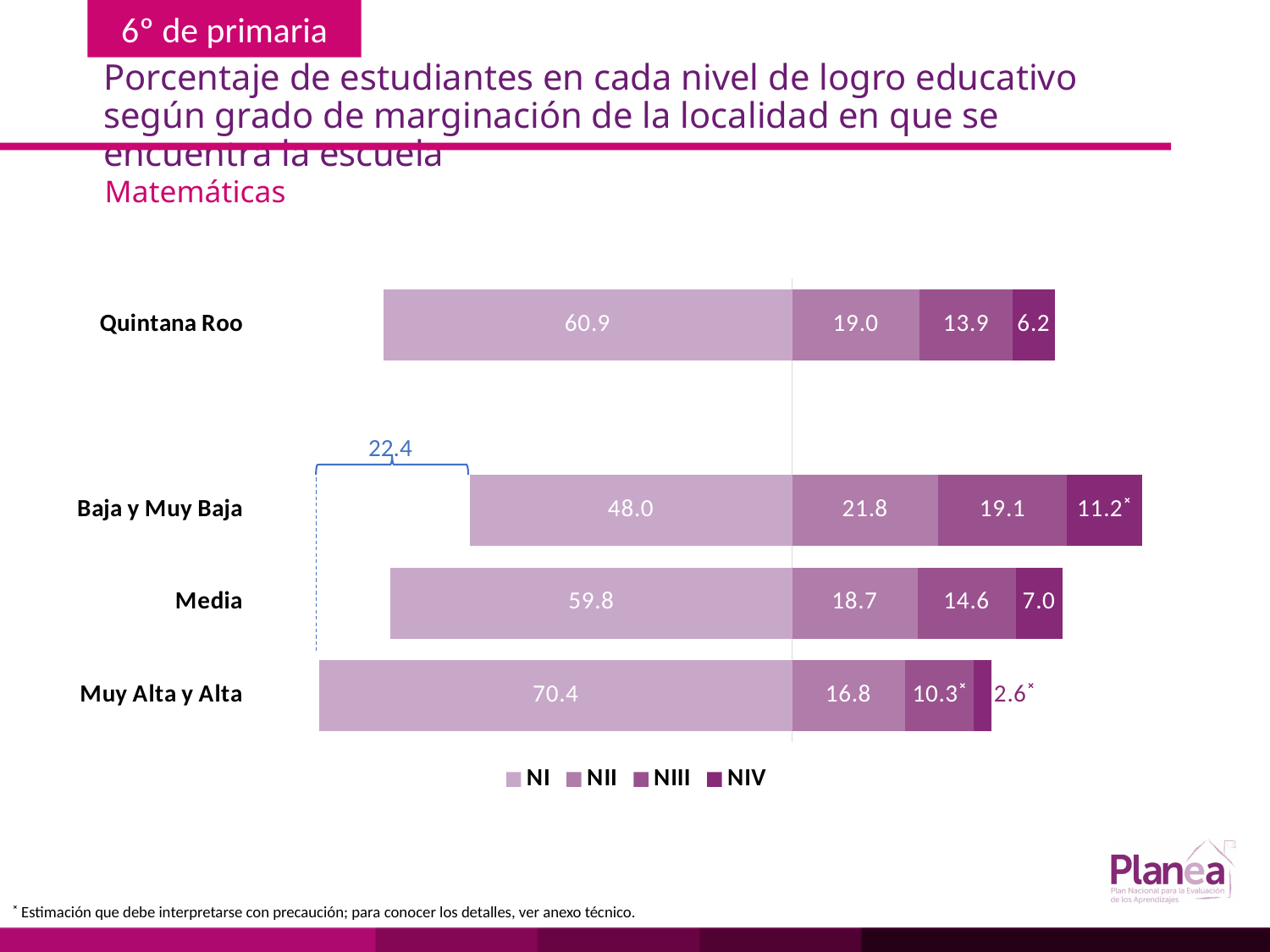
Which category has the lowest NIV value? Muy Alta y Alta What is the difference between the NI value for Muy Alta y Alta and the NI value for Baja y Muy Baja? 22.4 What is the NIII value for Media? 14.6 Which category has the highest NI value? Muy Alta y Alta What is the NIV value for Baja y Muy Baja? 11.2 How many categories are plotted on the chart? 4 What is the NII value for Muy Alta y Alta? 16.8 What is the NI value for Quintana Roo? 60.9 Which has the larger NII value, Baja y Muy Baja or Media? Baja y Muy Baja What kind of chart is shown on the slide? Stacked bar chart What are the legend entries of the chart? NI, NII, NIII, NIV How many series does the legend list? 4